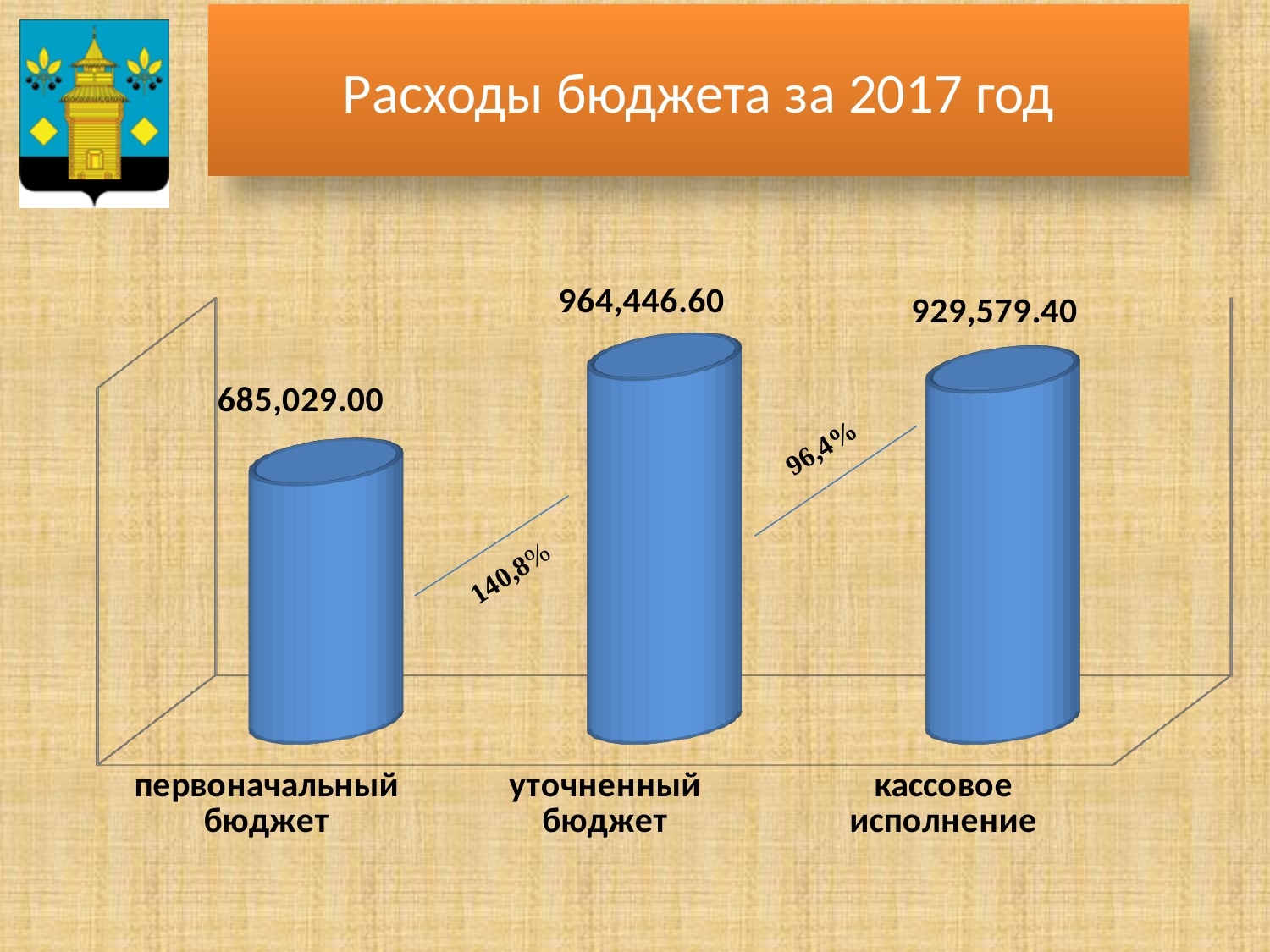
How many categories are shown in the chart? 3 What kind of chart is shown on the slide? bar chart Which category has the lowest value? первоначальный бюджет Which is larger, кассовое исполнение or первоначальный бюджет? кассовое исполнение What is the difference between уточненный бюджет and кассовое исполнение? 34,867.20 What is the difference between уточненный бюджет and первоначальный бюджет? 279,417.60 What is the value for кассовое исполнение? 929,579.40 What is the value for уточненный бюджет? 964,446.60 What is the value for первоначальный бюджет? 685,029.00 What is the title of the chart? Расходы бюджета за 2017 год What percentage is shown on the connector between первоначальный бюджет and уточненный бюджет? 140,8% Which category has the highest value? уточненный бюджет